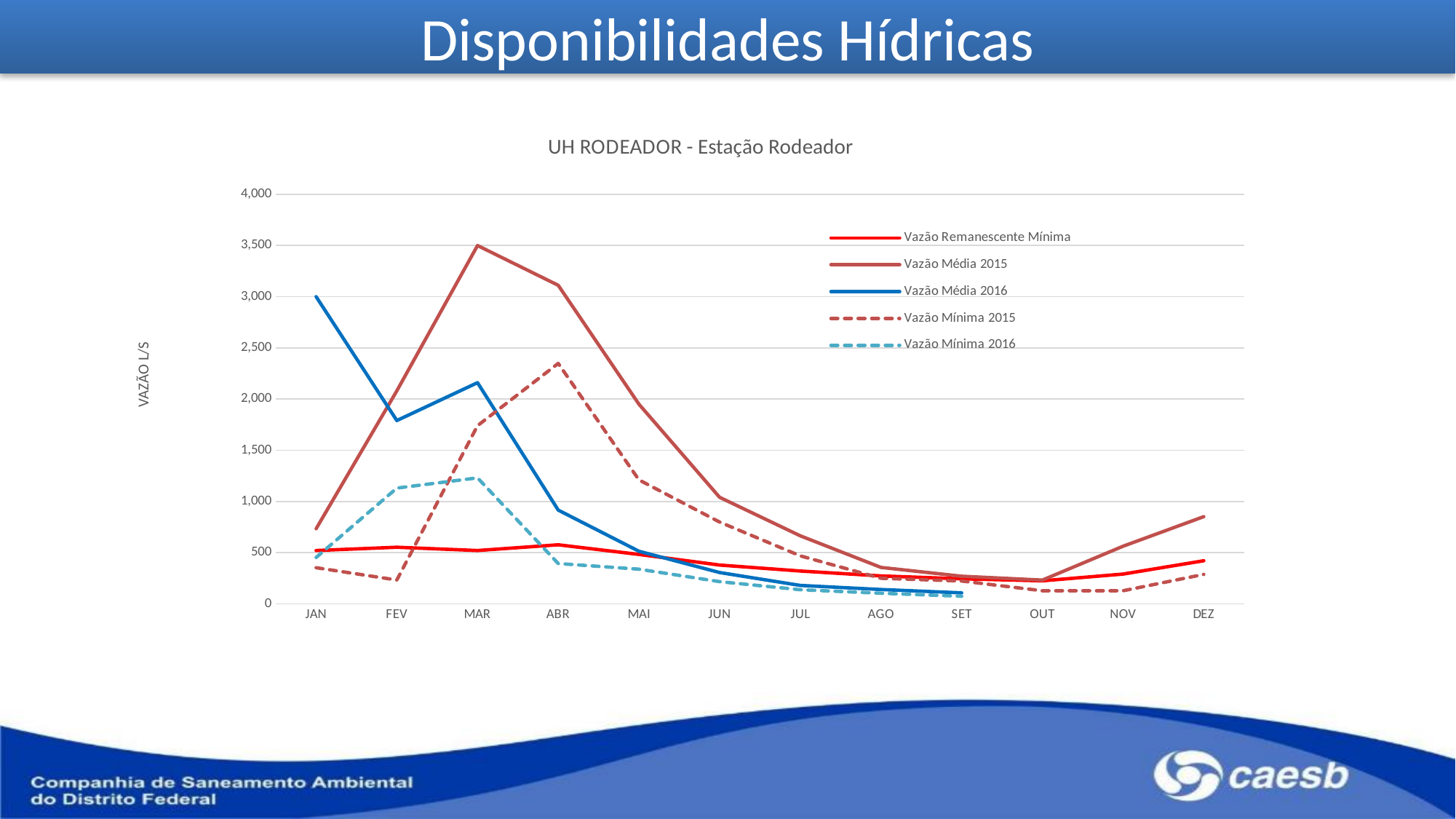
Is the value for Vazão Média 2015 in ABR greater or less than 3,000? greater In which month is Vazão Média 2015 at its lowest? OUT In which month does Vazão Média 2016 reach its highest value? JAN Does Vazão Média 2016 rise or fall from MAR to SET? fall How many months are shown on the x axis? 12 How many series does the legend list? 5 In which month does Vazão Mínima 2015 reach its highest value? ABR In which month does Vazão Média 2015 reach its highest value? MAR What is the title of the chart? UH RODEADOR - Estação Rodeador Is the value for Vazão Média 2016 in FEV greater or less than 2,000? less What kind of chart is shown on the slide? line chart In JAN, which is larger: Vazão Média 2015 or Vazão Média 2016? Vazão Média 2016